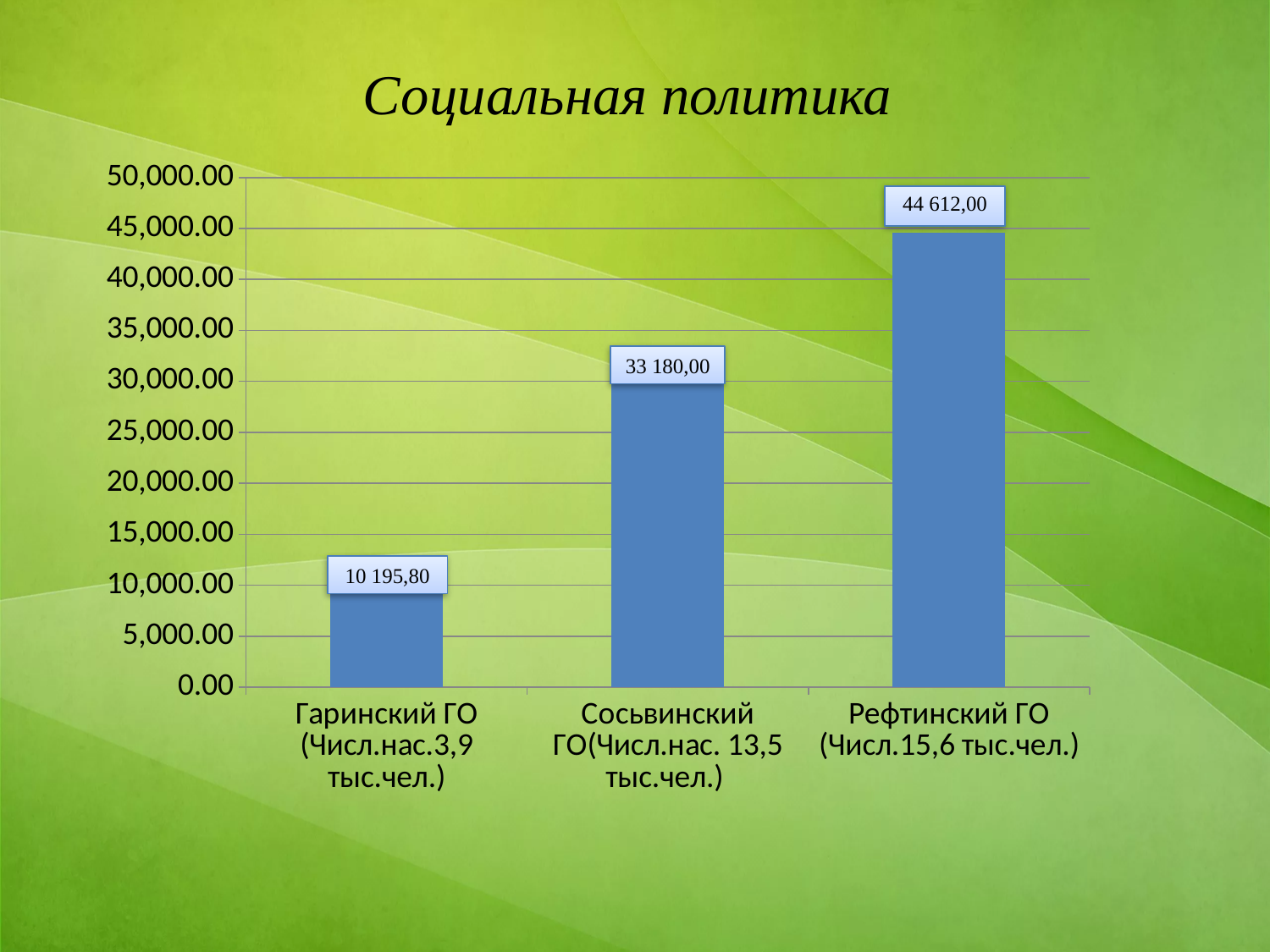
How many categories are shown in the chart? 3 What is the value for Сосьвинский ГО? 33 180,00 What is the difference between the values for Сосьвинский ГО and Гаринский ГО? 22 984,20 What is the value for Рефтинский ГО? 44 612,00 What is the difference between the values for Рефтинский ГО and Сосьвинский ГО? 11 432,00 What is the value for Гаринский ГО? 10 195,80 Is the value for Сосьвинский ГО greater or less than 30,000.00? greater What kind of chart is shown on the slide? bar chart What is the title of the slide? Социальная политика Which is larger, the value for Сосьвинский ГО or the value for Гаринский ГО? Сосьвинский ГО Which category has the lowest value? Гаринский ГО Which category has the highest value? Рефтинский ГО